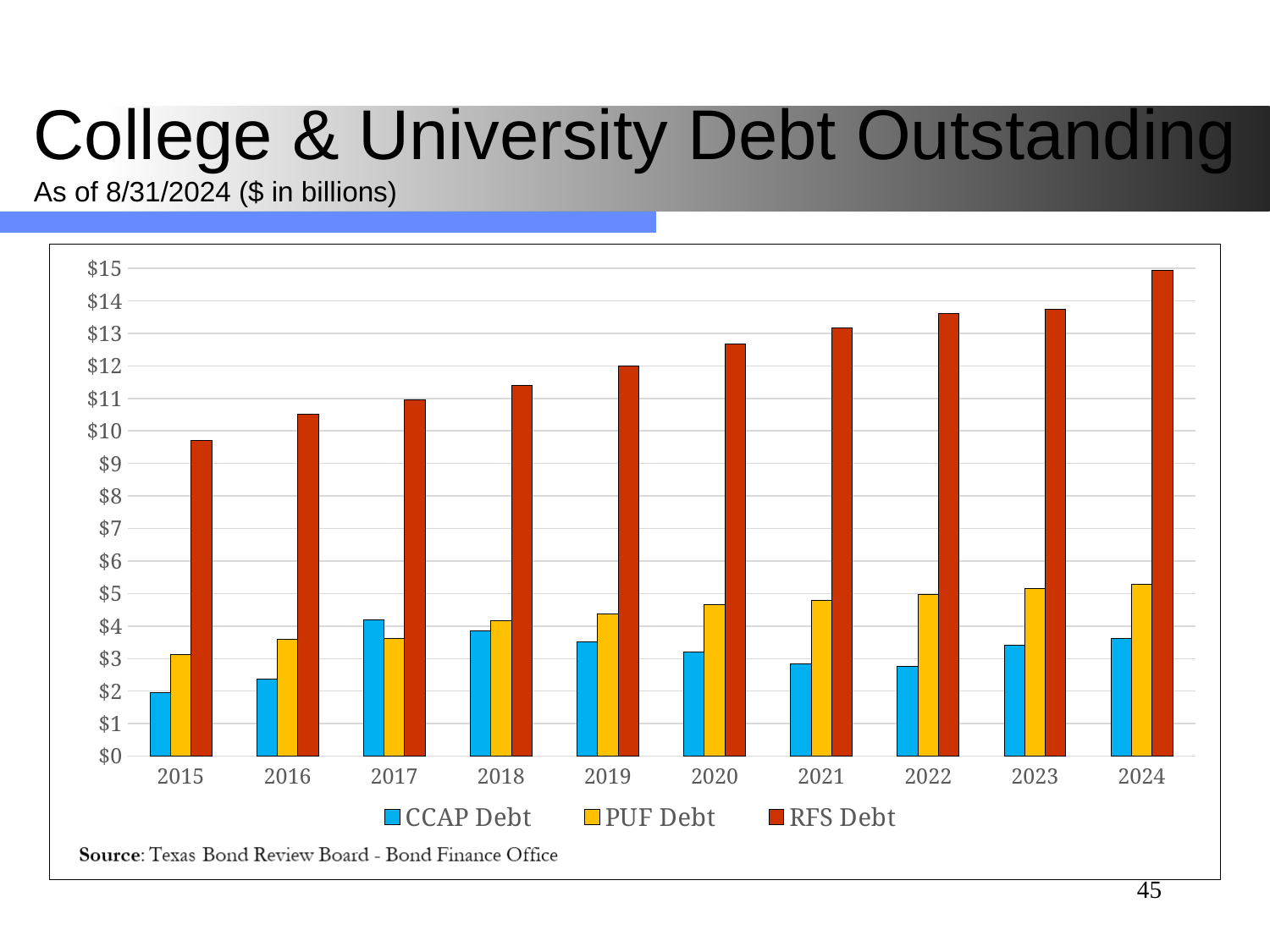
In 2017, which is larger: CCAP Debt or PUF Debt? CCAP Debt How many series does the legend list? 3 Does RFS Debt rise or fall from 2015 to 2024? rise Is the value for RFS Debt in 2015 greater or less than $10? less How many years are shown on the x axis? 10 What kind of chart is shown on the slide? bar chart Which series is shown in red? RFS Debt In which year is RFS Debt highest? 2024 In which year is CCAP Debt highest? 2017 Is the value for RFS Debt in 2024 greater or less than $14? greater In 2024, which is larger: PUF Debt or CCAP Debt? PUF Debt In which year is CCAP Debt lowest? 2015